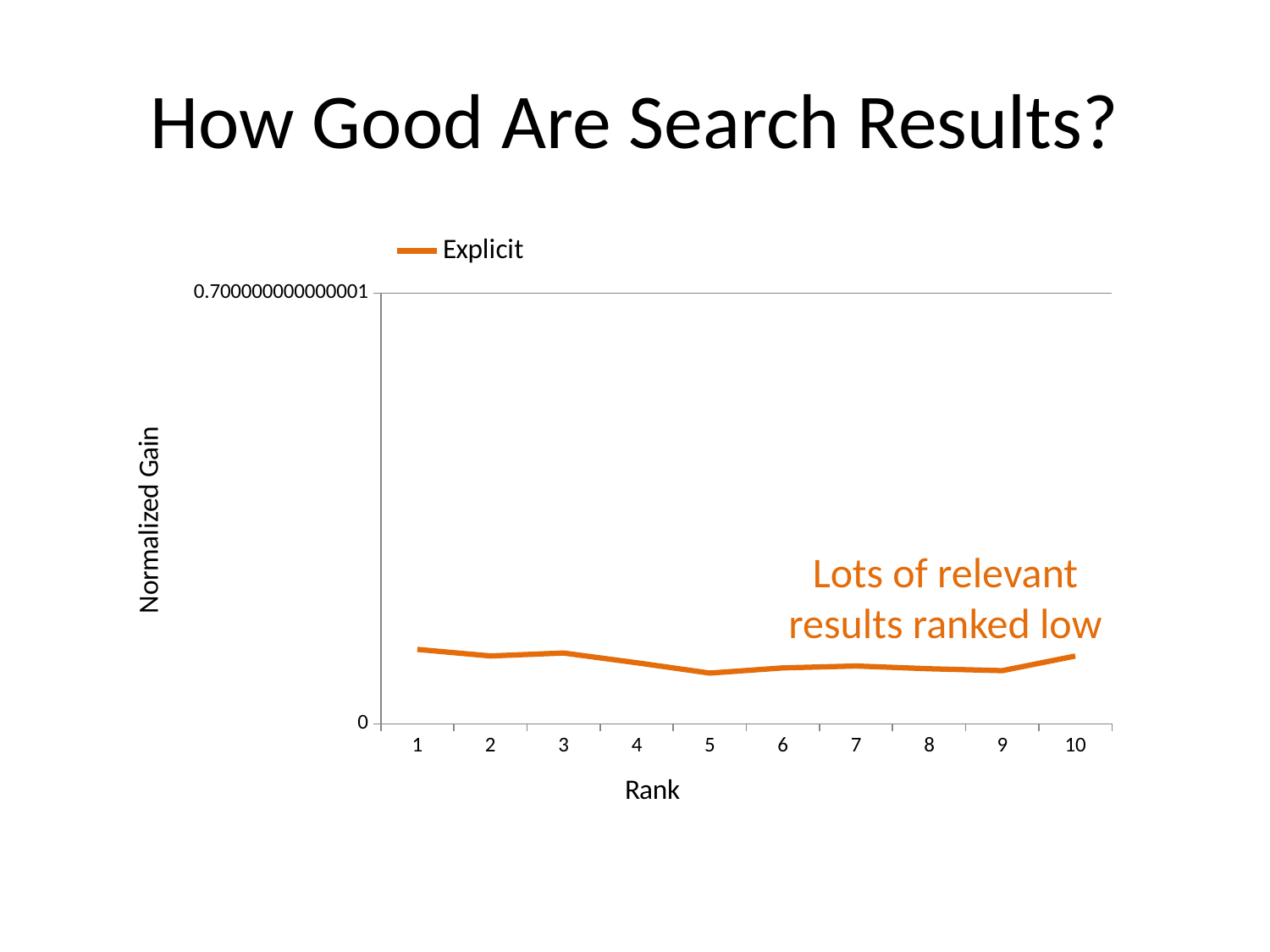
How many series does the legend list? 1 Is the Normalized Gain value at rank 1 greater or less than 0.7? less What is the name of the series shown in the legend? Explicit Between rank 1 and rank 5, does the Explicit line rise or fall? fall Is the Normalized Gain value at rank 5 greater or less than 0.7? less What is the title of the x axis? Rank Which has the larger Normalized Gain, rank 1 or rank 5? rank 1 Which has the larger Normalized Gain, rank 9 or rank 10? rank 10 What kind of chart is shown on the slide? line chart Which has the larger Normalized Gain, rank 3 or rank 5? rank 3 Between rank 9 and rank 10, does the Explicit line rise or fall? rise How many rank positions are plotted along the x axis? 10